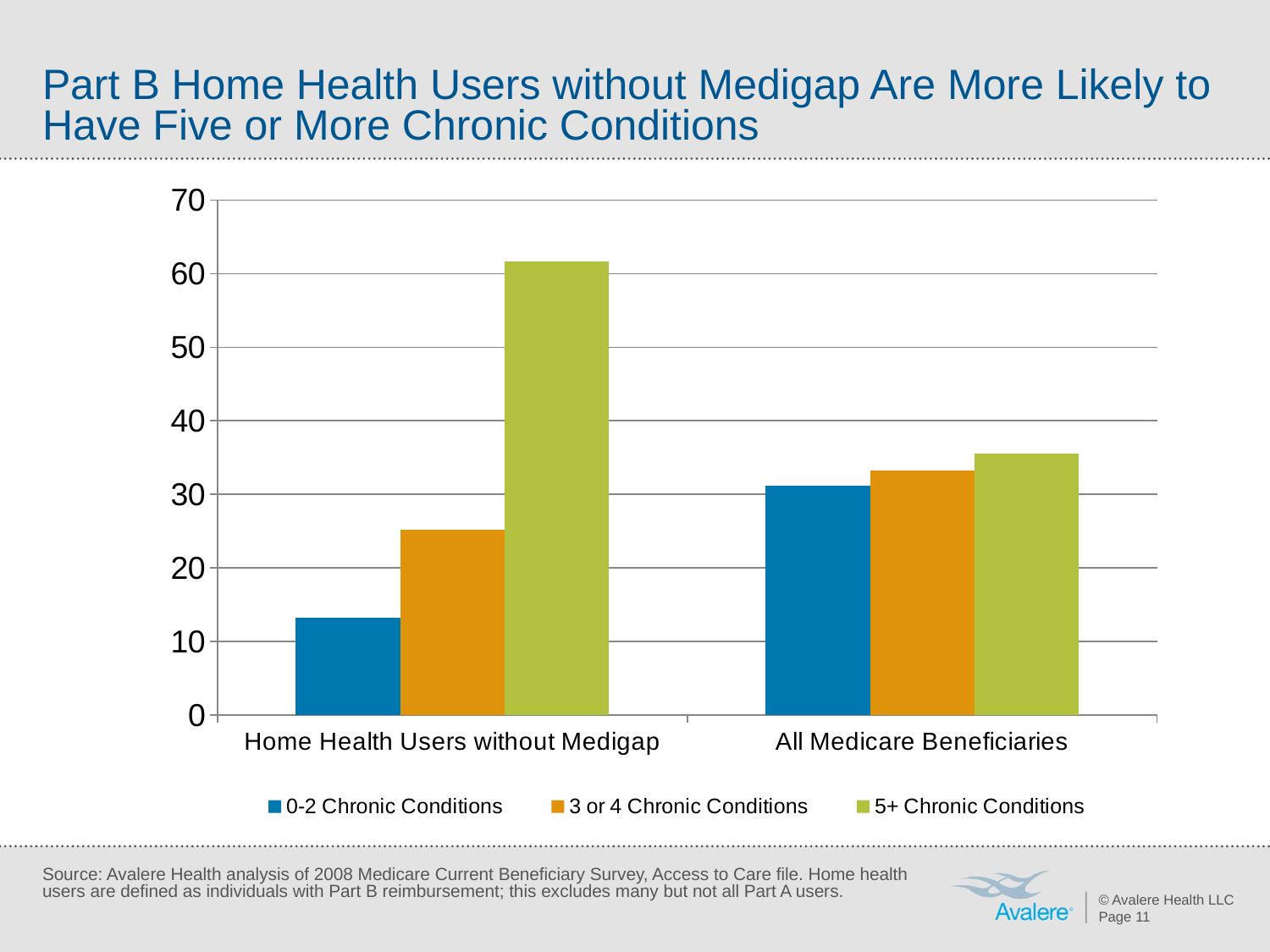
What colour represents the 3 or 4 Chronic Conditions series? orange Is the value for 3 or 4 Chronic Conditions among All Medicare Beneficiaries greater or less than 30? greater Which series has the lowest value for Home Health Users without Medigap? 0-2 Chronic Conditions How many series does the legend list? 3 Is the value for 0-2 Chronic Conditions among Home Health Users without Medigap greater or less than 20? less Which is larger: the 5+ Chronic Conditions value for Home Health Users without Medigap or for All Medicare Beneficiaries? Home Health Users without Medigap Which is larger: the 0-2 Chronic Conditions value for Home Health Users without Medigap or for All Medicare Beneficiaries? All Medicare Beneficiaries How many categories are shown on the x axis? 2 What kind of chart is shown on the slide? bar chart Is the value for 5+ Chronic Conditions among Home Health Users without Medigap greater or less than 60? greater Which series has the highest value for Home Health Users without Medigap? 5+ Chronic Conditions